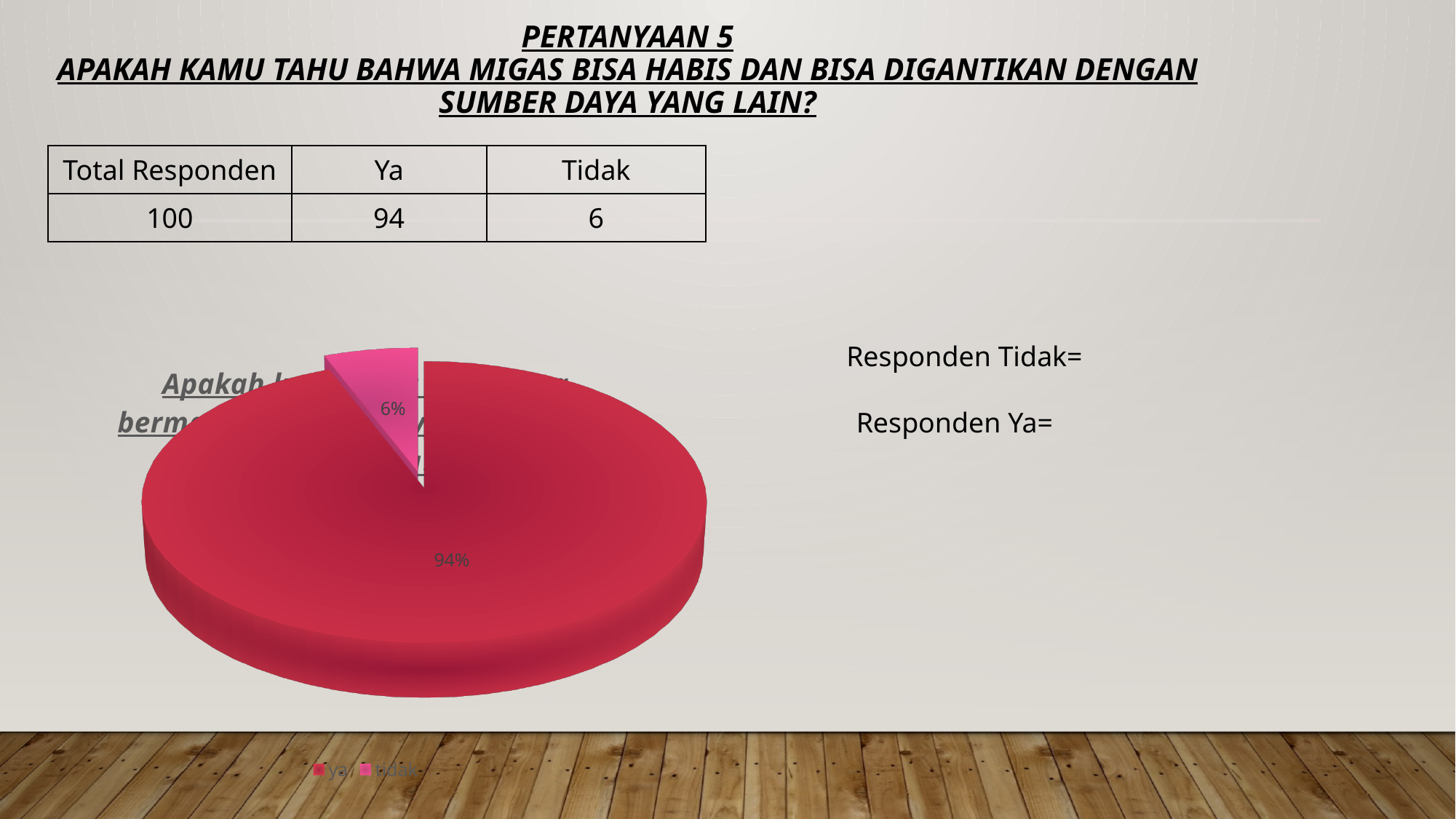
What colour is the "tidak" slice in the pie chart? pink What is the difference in percentage points between the "ya" and "tidak" slices? 88 What percentage of the pie chart is the "ya" slice? 94% What are the two entries listed in the pie chart's legend? ya, tidak What kind of chart is shown on the slide? pie chart What percentage of the pie chart is the "tidak" slice? 6% Which slice of the pie chart is the smallest? tidak Is the "ya" slice of the pie chart greater or less than 50%? greater Which slice of the pie chart is the largest? ya How many slices does the pie chart have? 2 Which is larger in the pie chart, the "ya" slice or the "tidak" slice? ya How many entries does the pie chart's legend list? 2